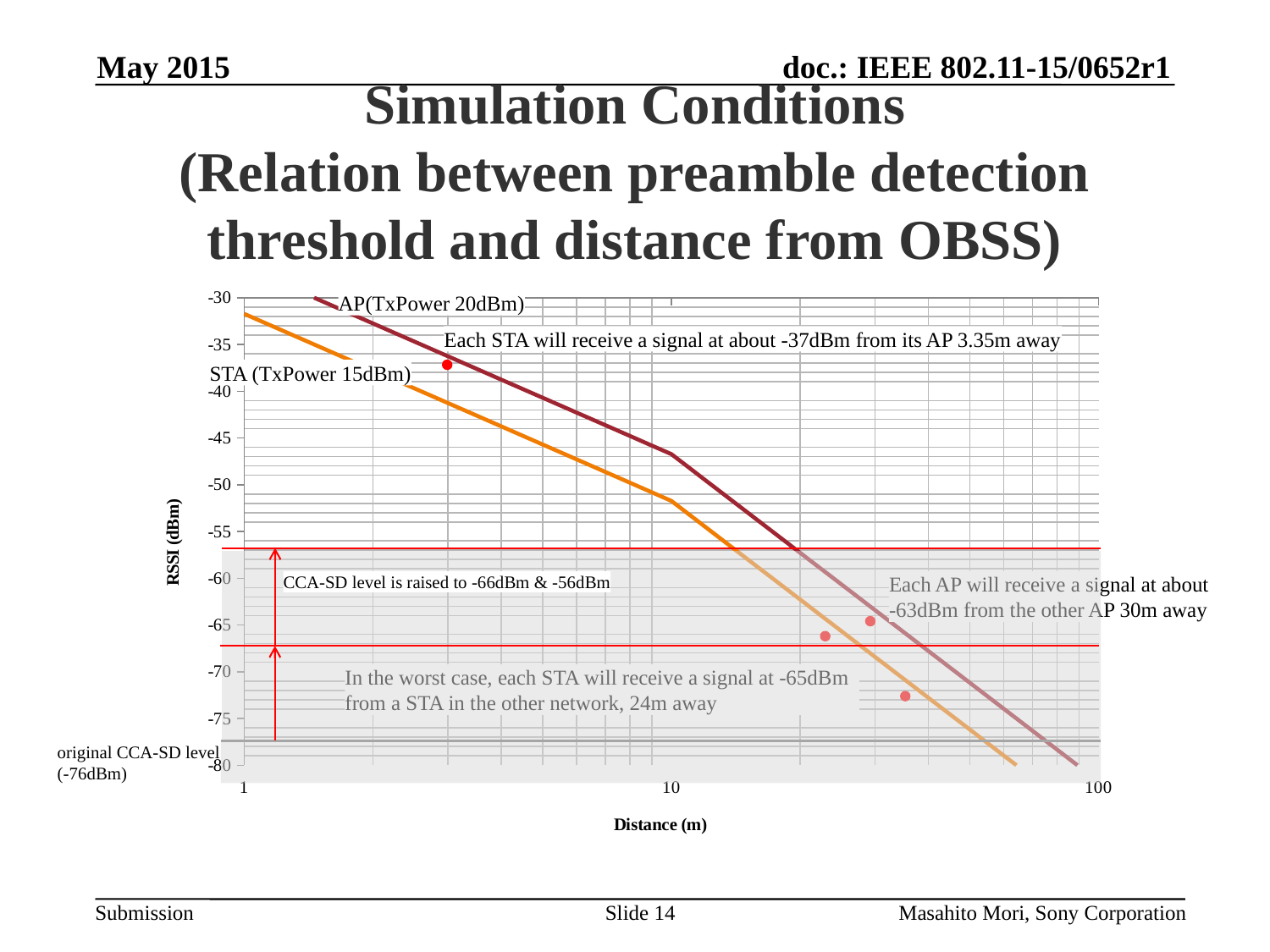
How many lines (series) are plotted in the chart? 2 According to the chart annotation, what signal level does each AP receive from the other AP 30 m away? -63dBm Is the RSSI of the AP (TxPower 20dBm) line at 10 m greater or less than -50 dBm? greater Do the RSSI values rise or fall as distance increases along the x axis? fall At a distance of 10 m, which line has the higher RSSI, AP (TxPower 20dBm) or STA (TxPower 15dBm)? AP (TxPower 20dBm) According to the chart annotation, what signal level does each STA receive from its AP 3.35 m away? -37dBm What is the label of the vertical axis of the chart? RSSI (dBm) Is the RSSI of the STA (TxPower 15dBm) line at 10 m greater or less than -50 dBm? less According to the chart annotation, what signal level does each STA receive in the worst case from a STA in the other network 24 m away? -65dBm What kind of chart is shown on the slide? line chart What is the label of the horizontal axis of the chart? Distance (m) What is the original CCA-SD level marked on the chart? -76dBm